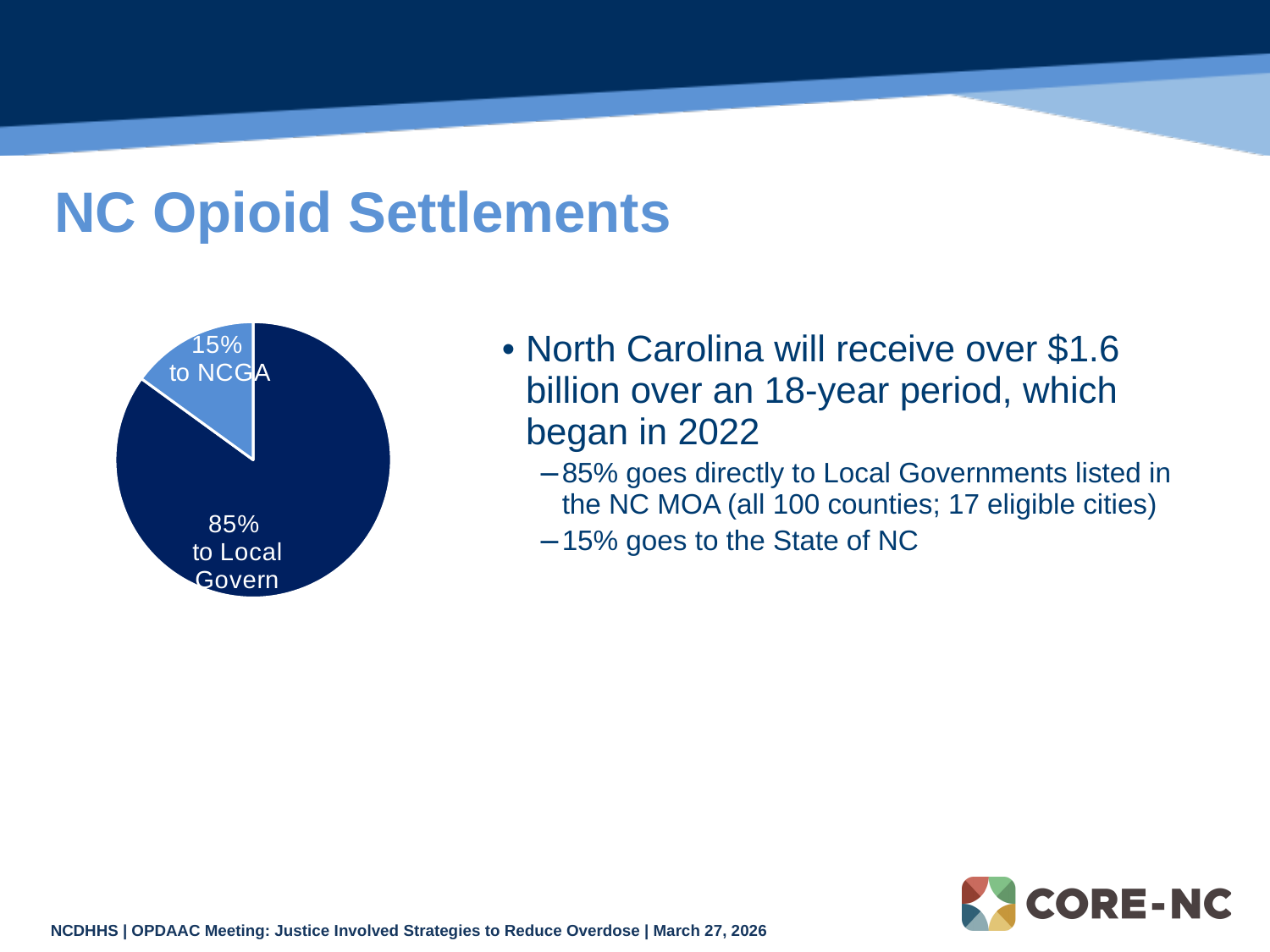
Which is larger, the share to NCGA or the share to Local Govern? Local Govern What colour is the slice labelled 15% to NCGA? Light blue What kind of chart is shown on the slide? Pie chart What is the difference in percentage points between the Local Govern slice and the NCGA slice? 70 What do the two slices of the pie chart add up to? 100% How many slices does the pie chart have? 2 What share of the pie goes to NCGA? 15% Which slice of the pie chart is the largest? 85% to Local Govern What share of the pie goes to Local Govern? 85% What colour is the slice labelled 85% to Local Govern? Dark navy blue Which slice of the pie chart is the smallest? 15% to NCGA